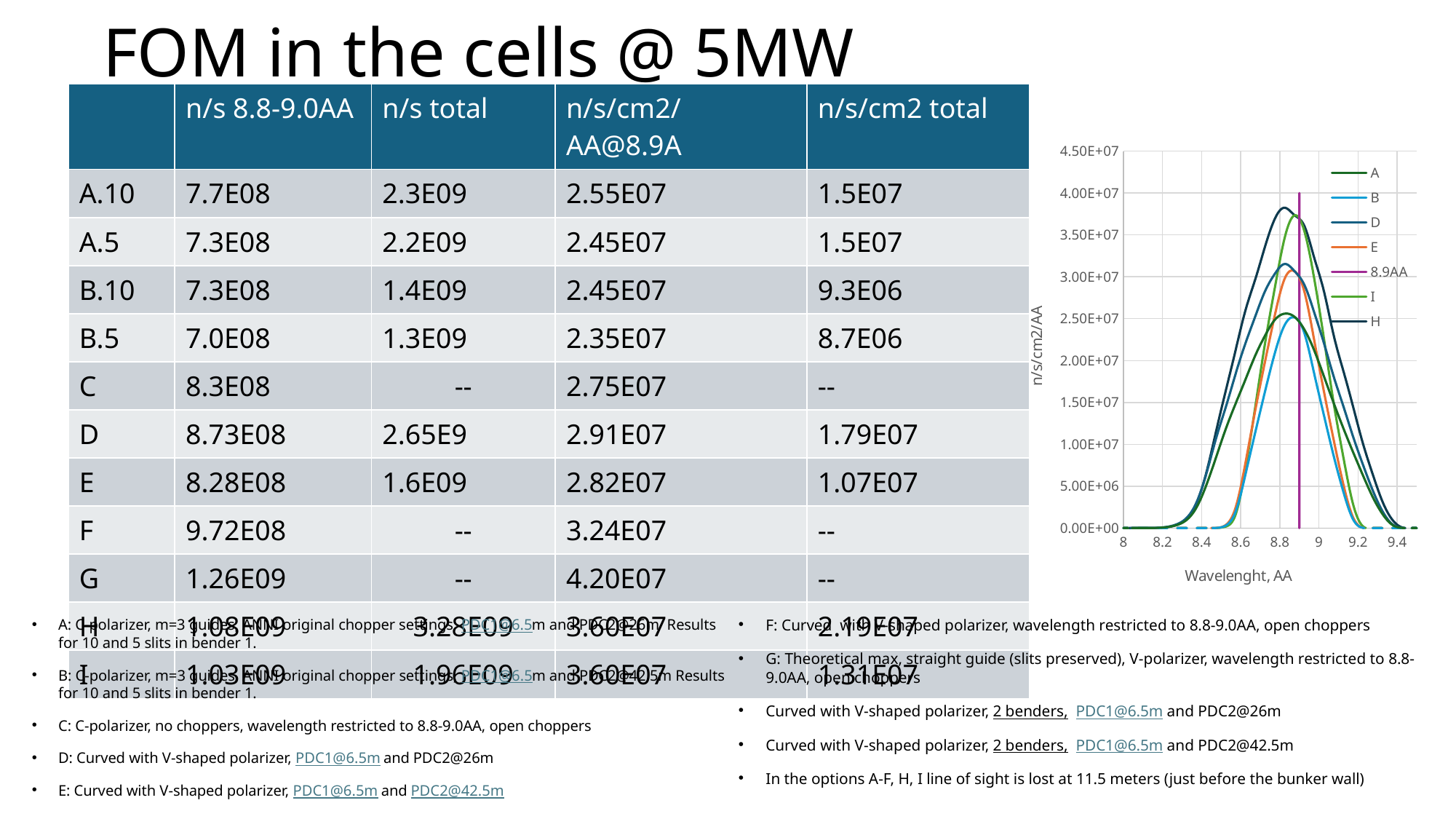
Is the peak value of series B greater or less than 3.00E+07? less What is the x-axis title of the chart? Wavelenght, AA Which series has a higher peak, I or A? I Do the curves rise or fall along the x axis between 8.4 and 8.8? rise Is the peak value of series H greater or less than 3.50E+07? greater Do the curves rise or fall along the x axis between 9.0 and 9.4? fall Is the peak value of series A greater or less than 3.00E+07? less Which series has a higher peak, H or B? H What kind of chart is shown on the right side of the slide? line chart What is the y-axis title of the chart? n/s/cm2/AA How many entries does the legend of the chart list? 7